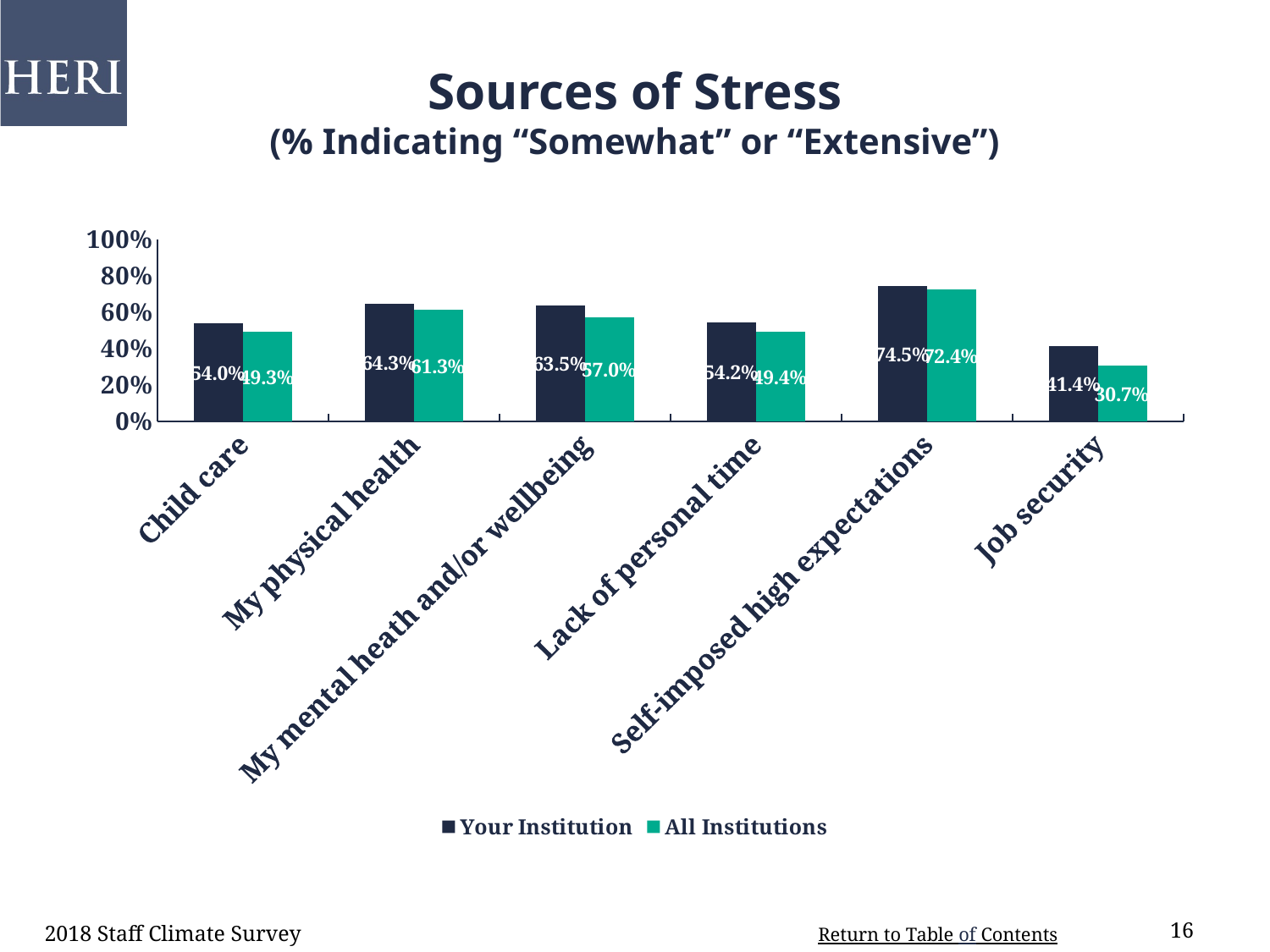
Which source of stress has the lowest value for All Institutions? Job security How many sources of stress are shown on the x axis? 6 For My mental heath and/or wellbeing, which is larger: Your Institution or All Institutions? Your Institution What is the value for Your Institution for Child care? 54.0% What is the value for All Institutions for My physical health? 61.3% What kind of chart is shown on the slide? Bar chart What is the value for All Institutions for Job security? 30.7% Which source of stress has the highest value for Your Institution? Self-imposed high expectations Is the value for All Institutions for Self-imposed high expectations greater or less than 60%? greater What is the difference between Your Institution and All Institutions for Job security? 10.7% What is the value for Your Institution for Self-imposed high expectations? 74.5% How many series does the legend list? 2